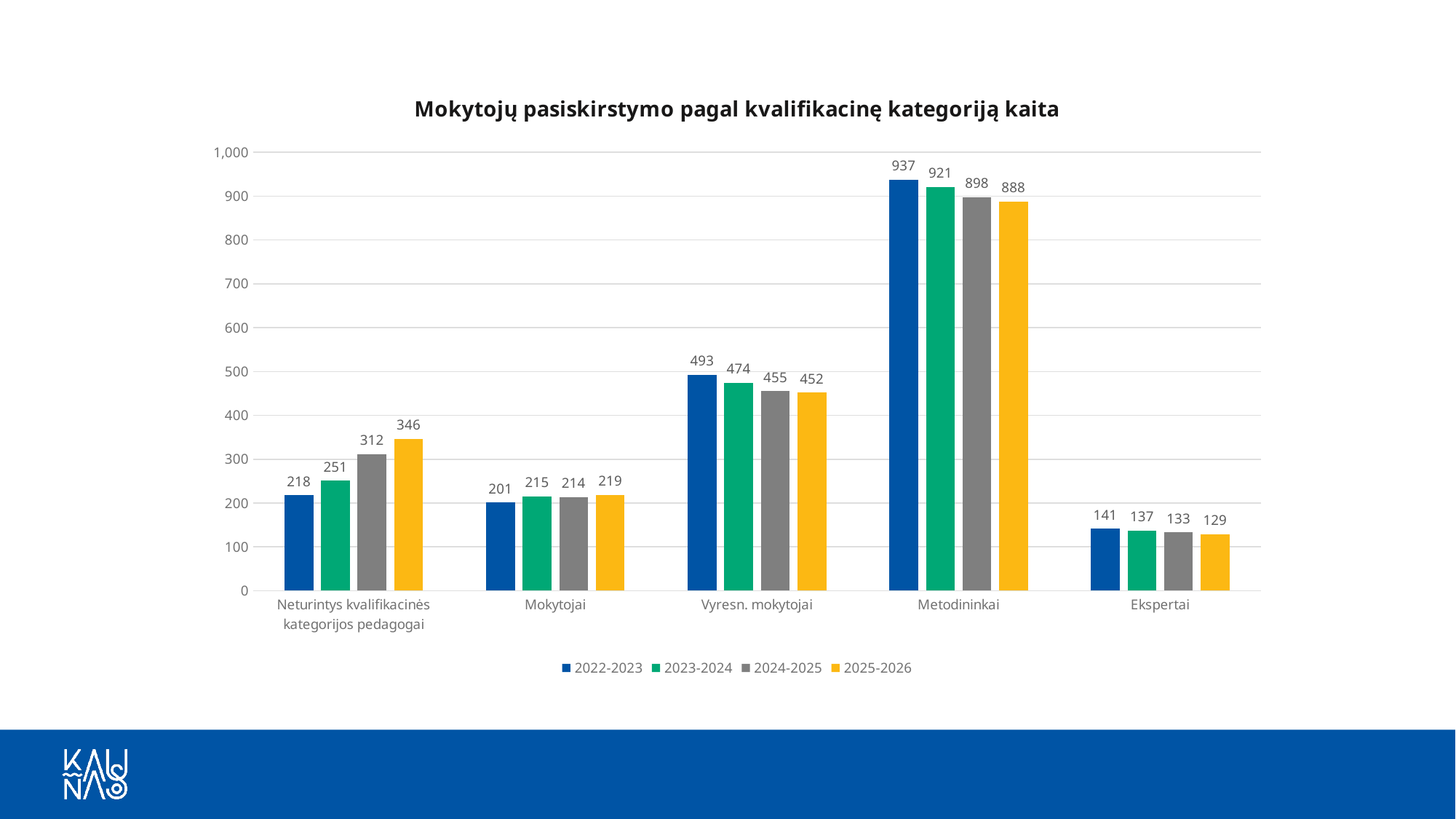
What is the value for Neturintys kvalifikacinės kategorijos pedagogai in 2025-2026? 346 What is the value for Metodininkai in 2022-2023? 937 How many categories are shown on the x axis? 5 What is the title of the chart? Mokytojų pasiskirstymo pagal kvalifikacinę kategoriją kaita What is the difference between the 2022-2023 and 2025-2026 values for Vyresn. mokytojai? 41 What kind of chart is shown on the slide? bar chart How many series does the legend list? 4 Do the values for Metodininkai rise or fall from 2022-2023 to 2025-2026? fall Which category has the highest value in 2023-2024? Metodininkai Which is larger for Mokytojai: the 2023-2024 value or the 2024-2025 value? 2023-2024 What is the value for Ekspertai in 2024-2025? 133 Which category has the lowest value in 2025-2026? Ekspertai